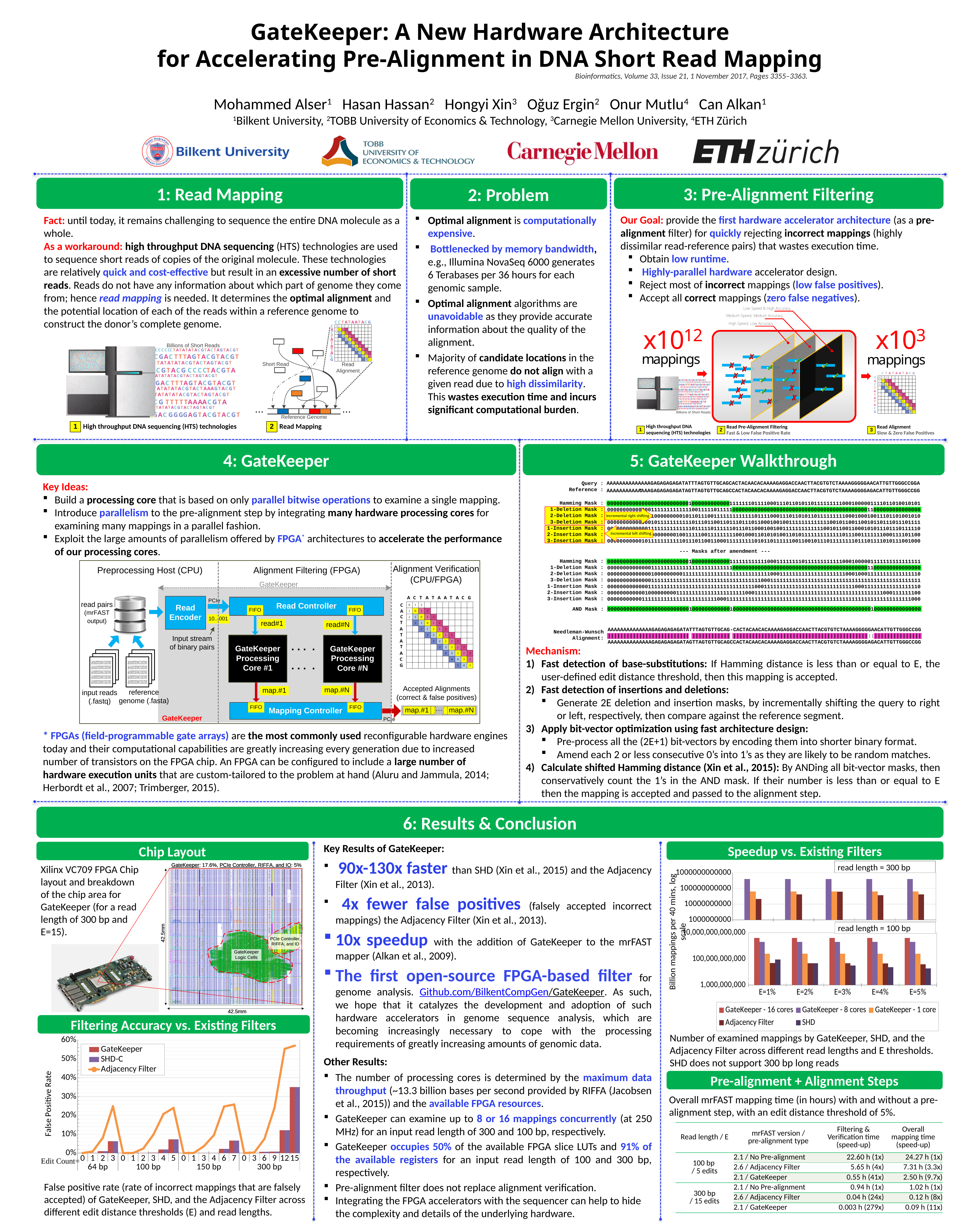
In the 'Speedup vs. Existing Filters' chart, how many series does the legend list? 5 In the 'Speedup vs. Existing Filters' chart for read length = 100 bp, is the GateKeeper - 16 cores value at E=1% greater or less than 100,000,000,000? greater In the 'Filtering Accuracy vs. Existing Filters' chart, how many series does the legend list? 3 In the 'Speedup vs. Existing Filters' chart for read length = 100 bp, which series has the highest value at E=1%? GateKeeper - 16 cores In the 'Filtering Accuracy vs. Existing Filters' chart, at edit count 3 for 64 bp reads, which is higher: the Adjacency Filter or GateKeeper? Adjacency Filter In the 'Filtering Accuracy vs. Existing Filters' chart, within the 300 bp group, does the Adjacency Filter false positive rate rise or fall as the edit count increases? rises In the 'Filtering Accuracy vs. Existing Filters' chart, what is the label of the y axis? False Positive Rate In the 'Filtering Accuracy vs. Existing Filters' chart, which series has the highest false positive rate at edit count 15 for 300 bp reads? Adjacency Filter In the 'Filtering Accuracy vs. Existing Filters' chart, how many read-length groups are shown along the x axis? 4 In the 'Speedup vs. Existing Filters' chart, how many edit distance thresholds (E values) are shown on the x axis? 5 In the 'Filtering Accuracy vs. Existing Filters' chart, which series is drawn as a line rather than bars? Adjacency Filter In the 'Filtering Accuracy vs. Existing Filters' chart, is the Adjacency Filter false positive rate at edit count 15 for 300 bp reads greater or less than 50%? greater